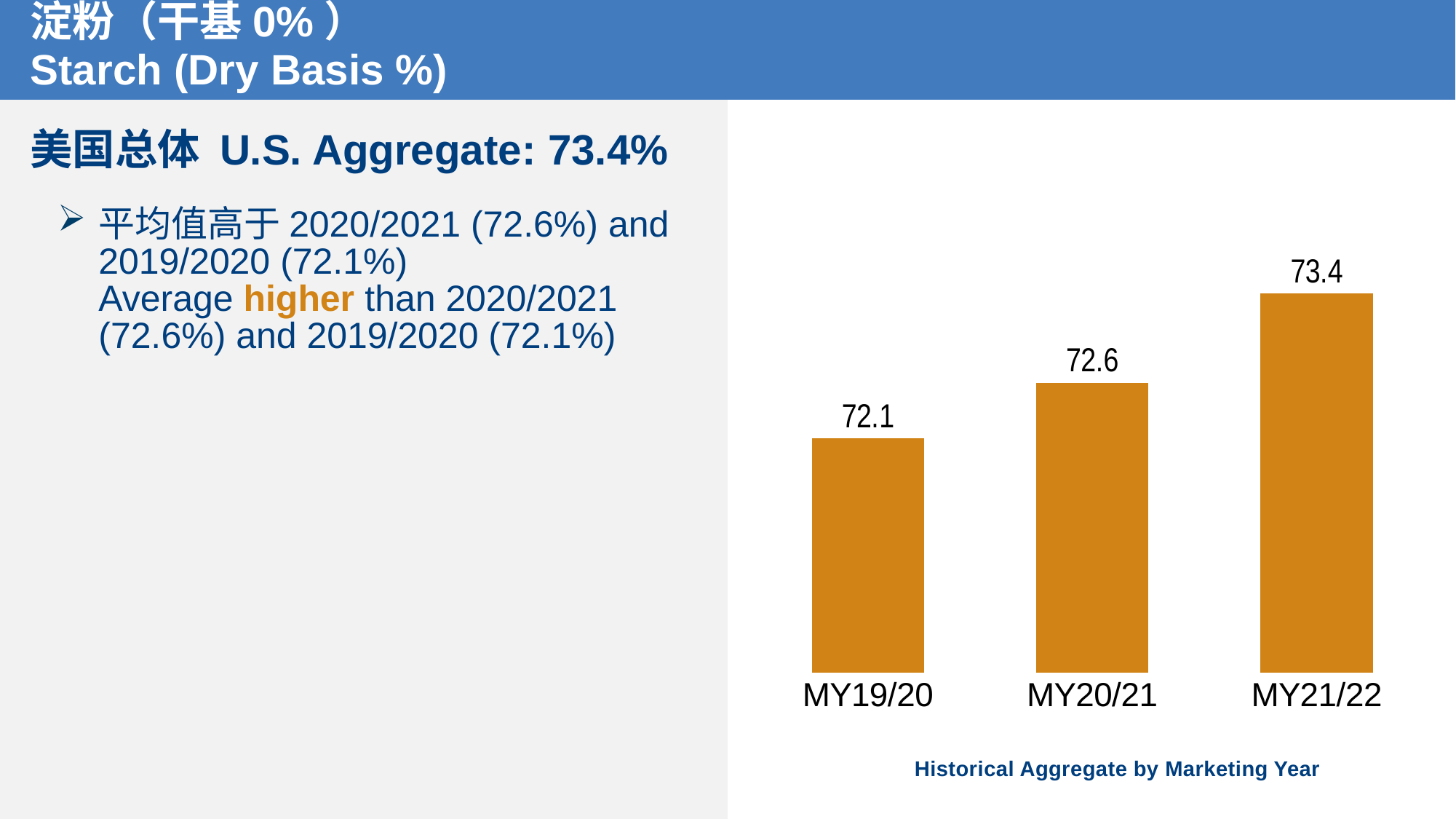
Which marketing year has the highest value? MY21/22 What is the value for MY19/20? 72.1 What is the difference between the values for MY21/22 and MY20/21? 0.8 What is the value for MY21/22? 73.4 Do the values rise or fall from MY19/20 to MY21/22? Rise How many marketing years are shown in the chart? 3 What kind of chart is shown on the slide? Bar chart What is the value for MY20/21? 72.6 Which marketing year has the lowest value? MY19/20 What is the difference between the values for MY21/22 and MY19/20? 1.3 Which is larger, the value for MY20/21 or MY19/20? MY20/21 What is the caption below the chart? Historical Aggregate by Marketing Year